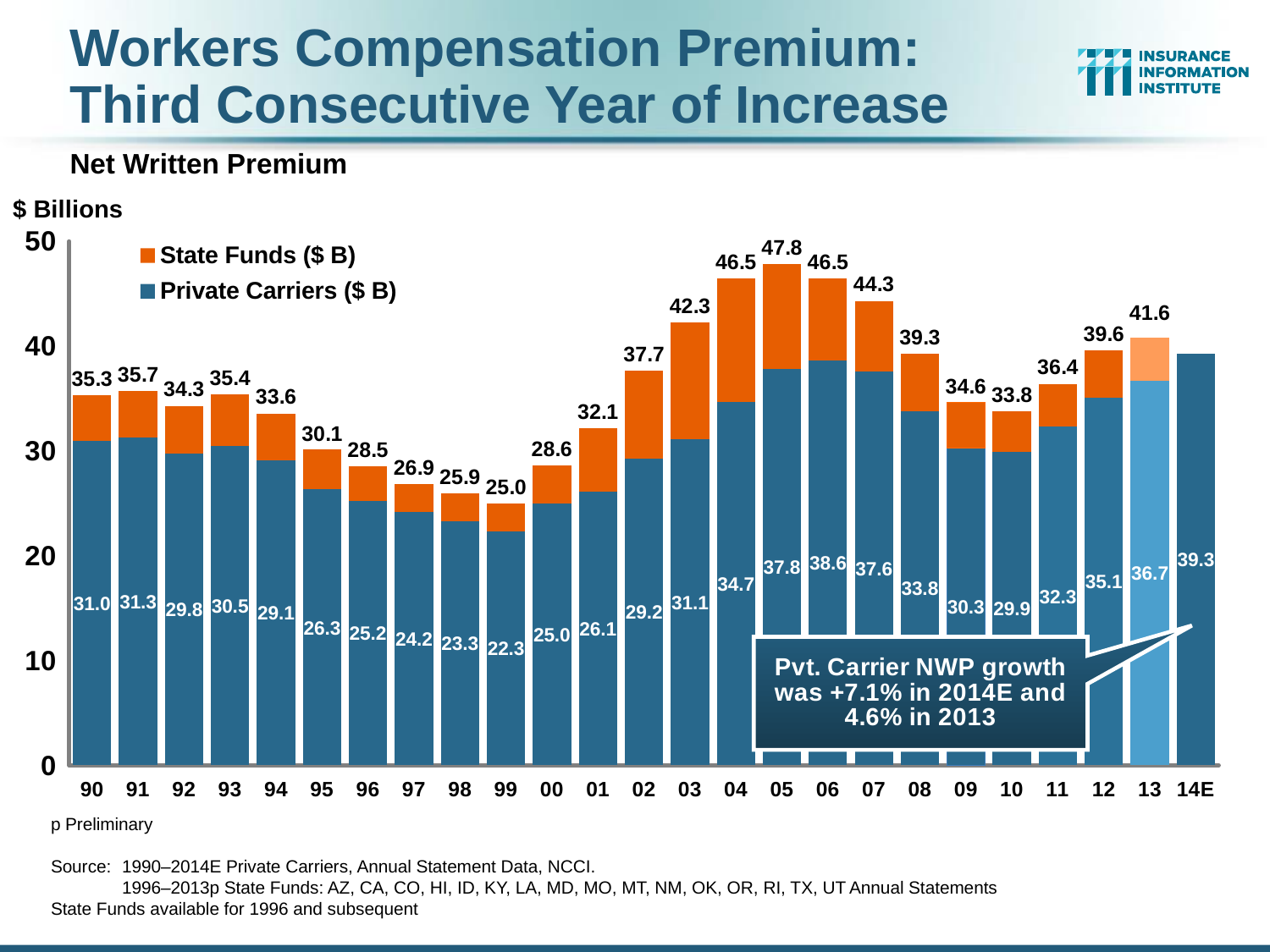
Which year has the lowest total net written premium? 99 Did the total net written premium rise or fall from 99 to 05? rise Which is larger, the total net written premium in 03 or in 13? 03 What was the Private Carriers net written premium in 14E? 39.3 What is the difference between the total net written premium in 13 and in 12? 2.0 What kind of chart is shown on the slide? Stacked bar chart Which year has the highest total net written premium? 05 What was the Private Carriers net written premium in 06? 38.6 What was the total net written premium in 05? 47.8 How many years are shown on the x axis? 25 How many series does the legend list? 2 Is the total net written premium in 99 greater or less than 30? less